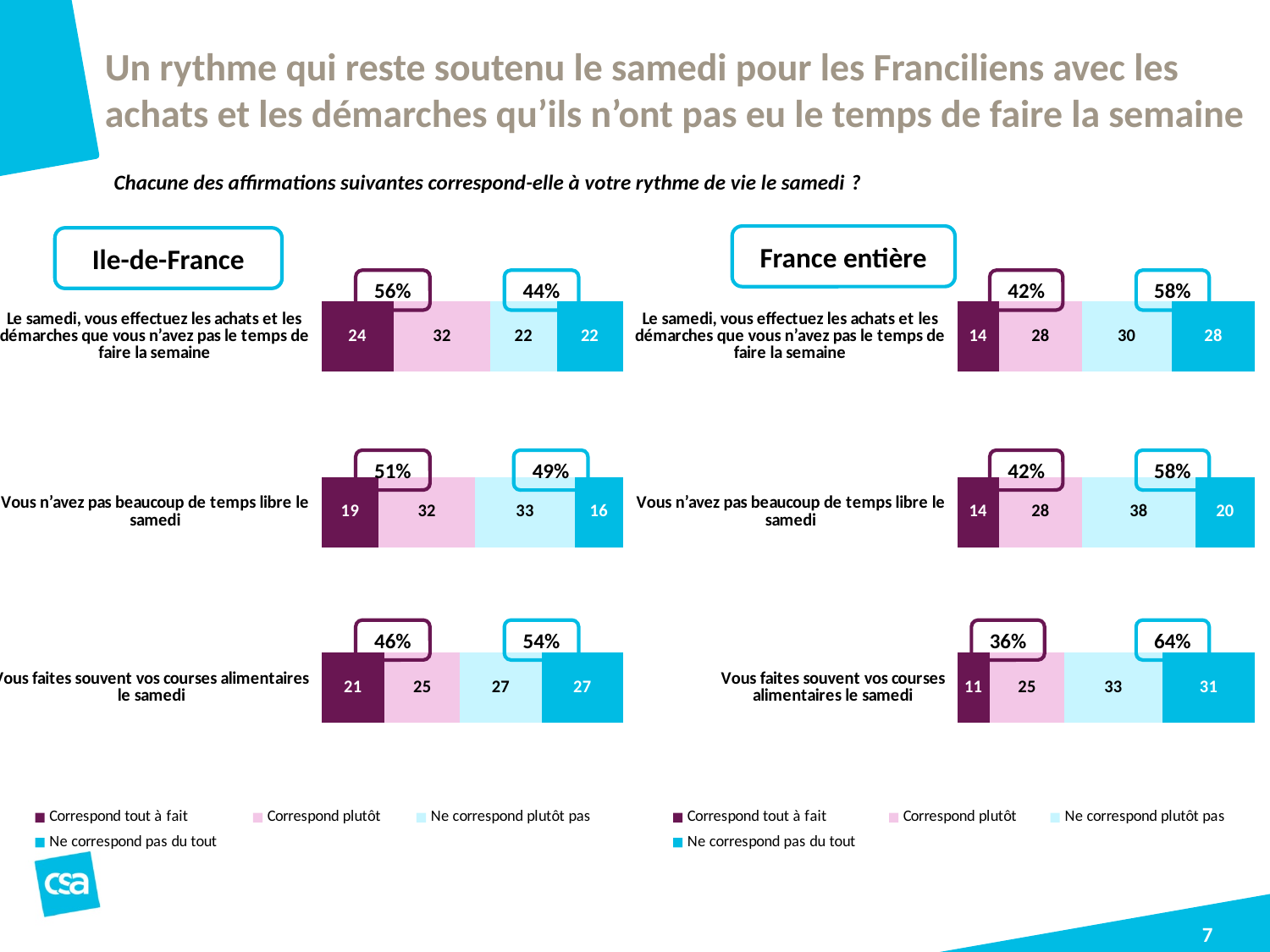
In the Ile-de-France chart, what is the combined percentage shown for "Correspond tout à fait" and "Correspond plutôt" for "Vous n'avez pas beaucoup de temps libre le samedi"? 51% How many statements (categories) are shown in the France entière chart? 3 In the Ile-de-France chart, which is larger for "Vous faites souvent vos courses alimentaires le samedi": "Correspond plutôt" or "Ne correspond plutôt pas"? Ne correspond plutôt pas In the France entière chart, which statement has the lowest value for "Correspond tout à fait"? Vous faites souvent vos courses alimentaires le samedi How many series does the legend of the Ile-de-France chart list? 4 What kind of chart is the Ile-de-France chart? Stacked bar chart In the France entière chart, what is the value of "Ne correspond pas du tout" for "Vous faites souvent vos courses alimentaires le samedi"? 31 In the France entière chart, what is the total of the stacked bar for "Vous n'avez pas beaucoup de temps libre le samedi"? 100 In the Ile-de-France chart, what is the value of "Correspond tout à fait" for "Le samedi, vous effectuez les achats et les démarches que vous n'avez pas le temps de faire la semaine"? 24 What is the difference between the "Correspond tout à fait" value for "Le samedi, vous effectuez les achats et les démarches..." in the Ile-de-France chart and in the France entière chart? 10 In the France entière chart, what is the value of "Ne correspond plutôt pas" for "Vous n'avez pas beaucoup de temps libre le samedi"? 38 In the Ile-de-France chart, which statement has the highest value for "Ne correspond pas du tout"? Vous faites souvent vos courses alimentaires le samedi